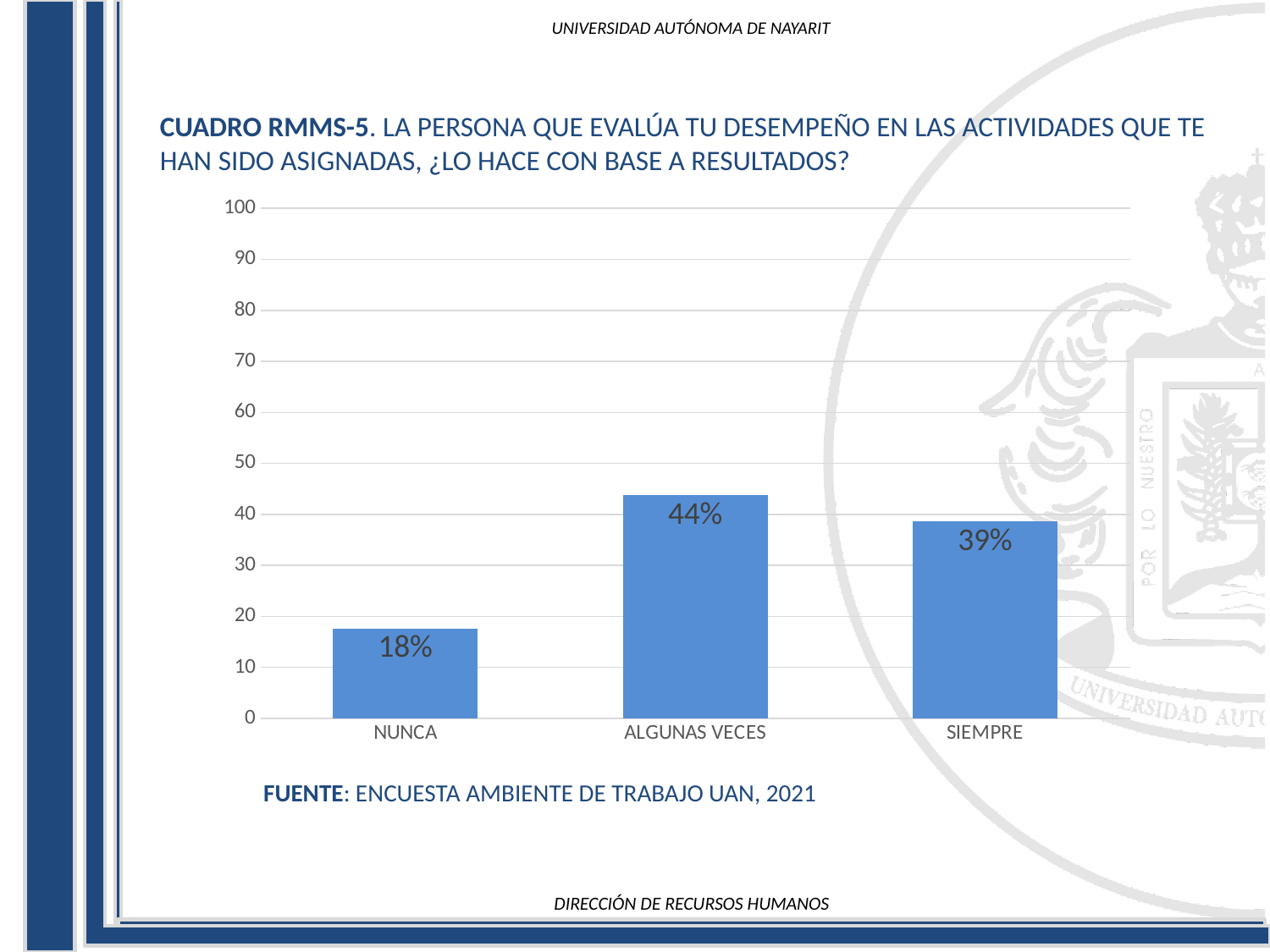
What is the value for SIEMPRE? 39% Is the value for ALGUNAS VECES greater or less than 50? less How many categories are shown on the x axis? 3 What is the difference between the values for ALGUNAS VECES and SIEMPRE? 5% Which is larger, the value for NUNCA or the value for SIEMPRE? SIEMPRE What is the value for NUNCA? 18% Which category has the highest value? ALGUNAS VECES What kind of chart is shown on the slide? bar chart What is the source cited below the chart? ENCUESTA AMBIENTE DE TRABAJO UAN, 2021 What is the value for ALGUNAS VECES? 44% Which category has the lowest value? NUNCA What is the difference between the values for SIEMPRE and NUNCA? 21%